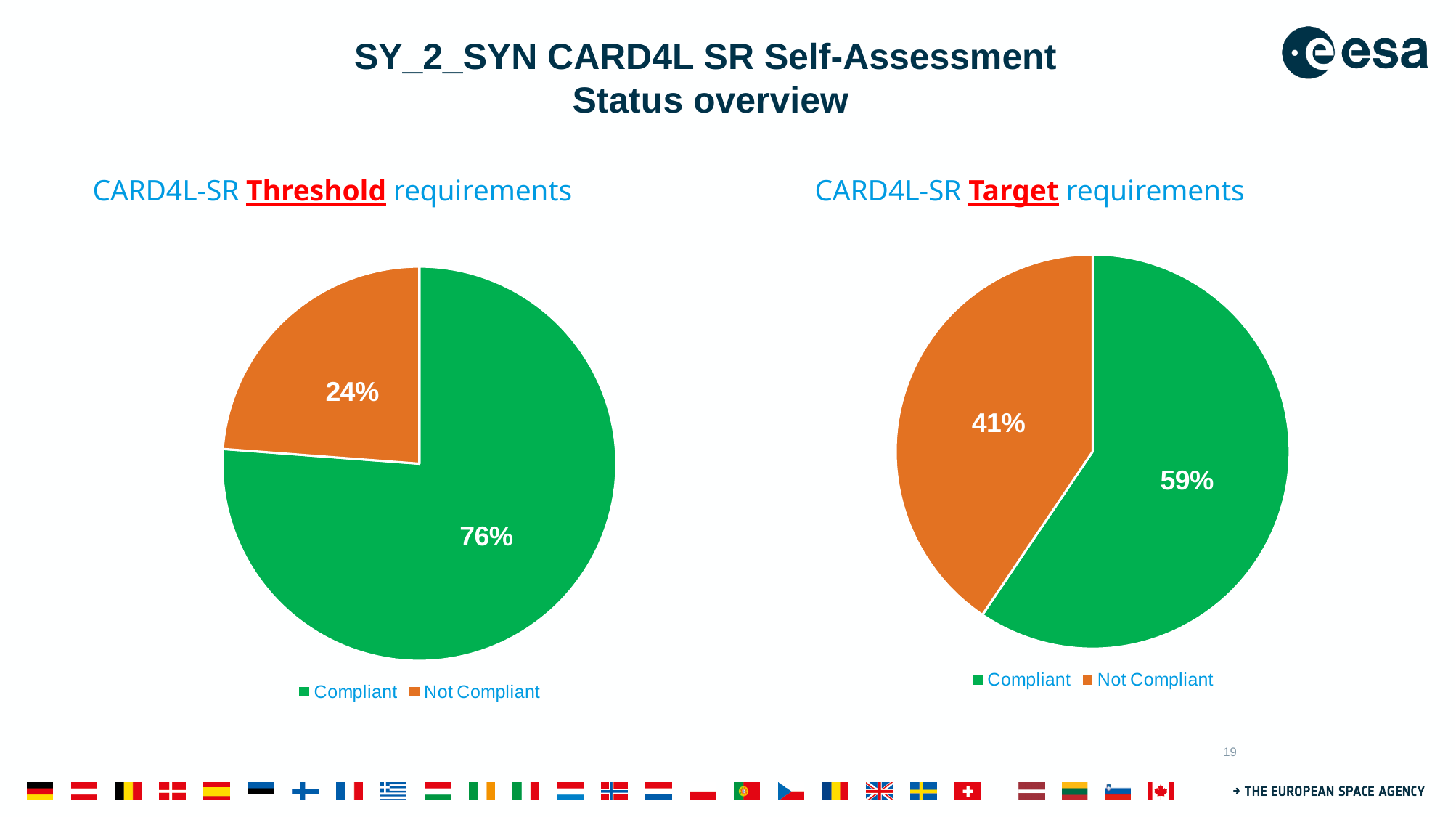
Is the Compliant share larger in the CARD4L-SR Threshold requirements chart or the CARD4L-SR Target requirements chart? Threshold requirements In the CARD4L-SR Target requirements chart, what share is Not Compliant? 41% In the CARD4L-SR Target requirements chart, which slice is the smallest? Not Compliant In the CARD4L-SR Target requirements chart, what colour represents Not Compliant? Orange In the CARD4L-SR Threshold requirements chart, what share is Not Compliant? 24% What type of chart is the CARD4L-SR Target requirements chart? Pie chart In the CARD4L-SR Target requirements chart, what is the difference between the Compliant and Not Compliant shares? 18% How many slices does the CARD4L-SR Threshold requirements chart have? 2 In the CARD4L-SR Threshold requirements chart, what share is Compliant? 76% In the CARD4L-SR Threshold requirements chart, which slice is the largest? Compliant In the CARD4L-SR Threshold requirements chart, what is the difference between the Compliant and Not Compliant shares? 52% In the CARD4L-SR Target requirements chart, what share is Compliant? 59%